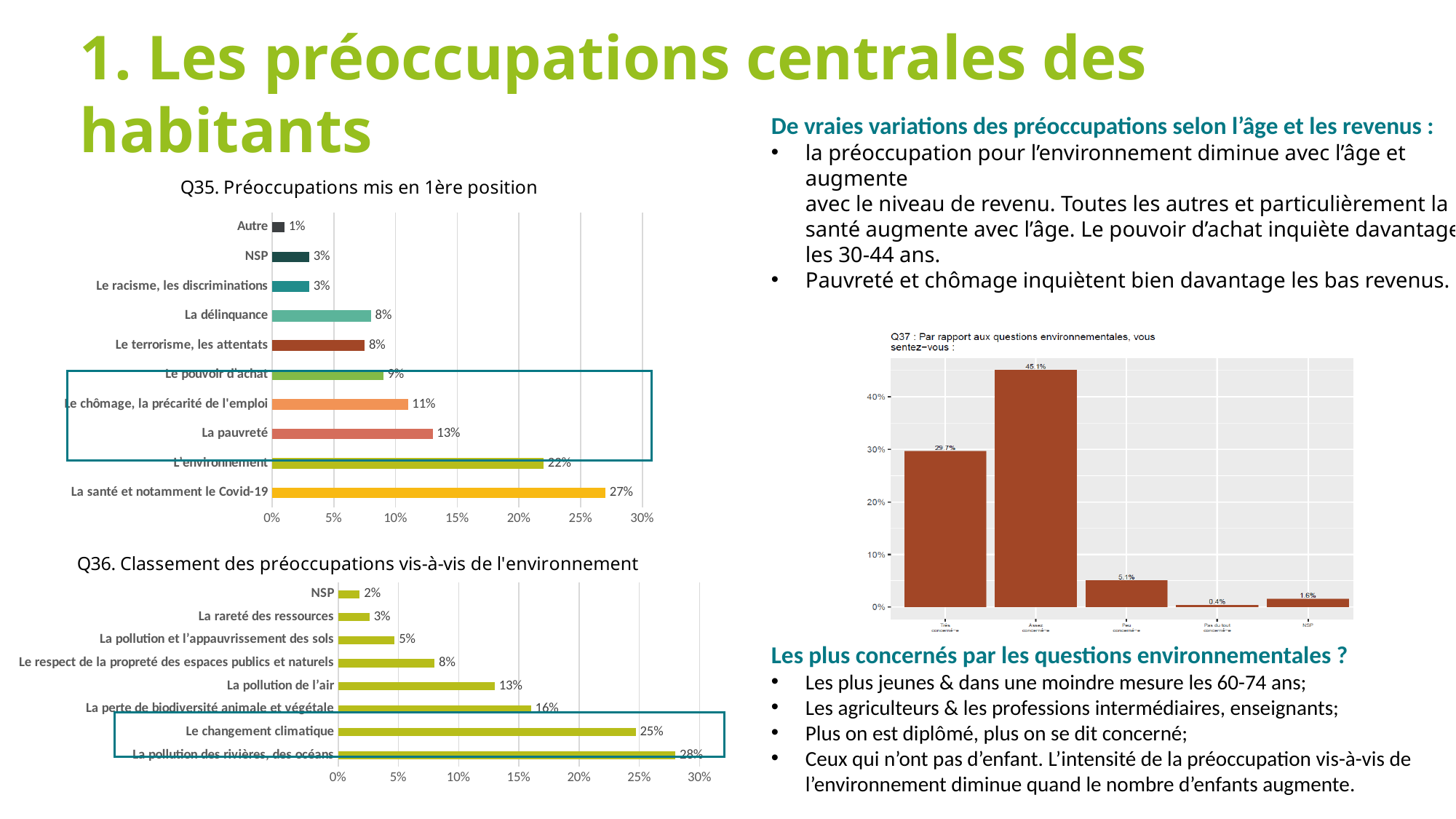
In the Q37 chart, which category has the lowest value? Pas du tout concerné In the Q36 chart, which is larger: 'Le changement climatique' or 'La perte de biodiversité animale et végétale'? Le changement climatique In the Q36 chart (Classement des préoccupations vis-à-vis de l'environnement), what is the value for 'La pollution de l'air'? 13% In the Q35 chart, what is the difference between 'L'environnement' and 'Le chômage, la précarité de l'emploi'? 11% In the Q36 chart, which category has the highest value? La pollution des rivières, des océans What kind of chart is the Q37 chart? Bar chart In the Q37 chart (Par rapport aux questions environnementales, vous sentez-vous), what is the value for 'Assez concerné'? 45.1% In the Q35 chart (Préoccupations mis en 1ère position), what is the value for 'La santé et notamment le Covid-19'? 27% In the Q35 chart, how many categories are plotted? 10 In the Q36 chart, how many categories are plotted? 8 In the Q35 chart, what is the value for 'La pauvreté'? 13% In the Q35 chart, which category has the highest value? La santé et notamment le Covid-19